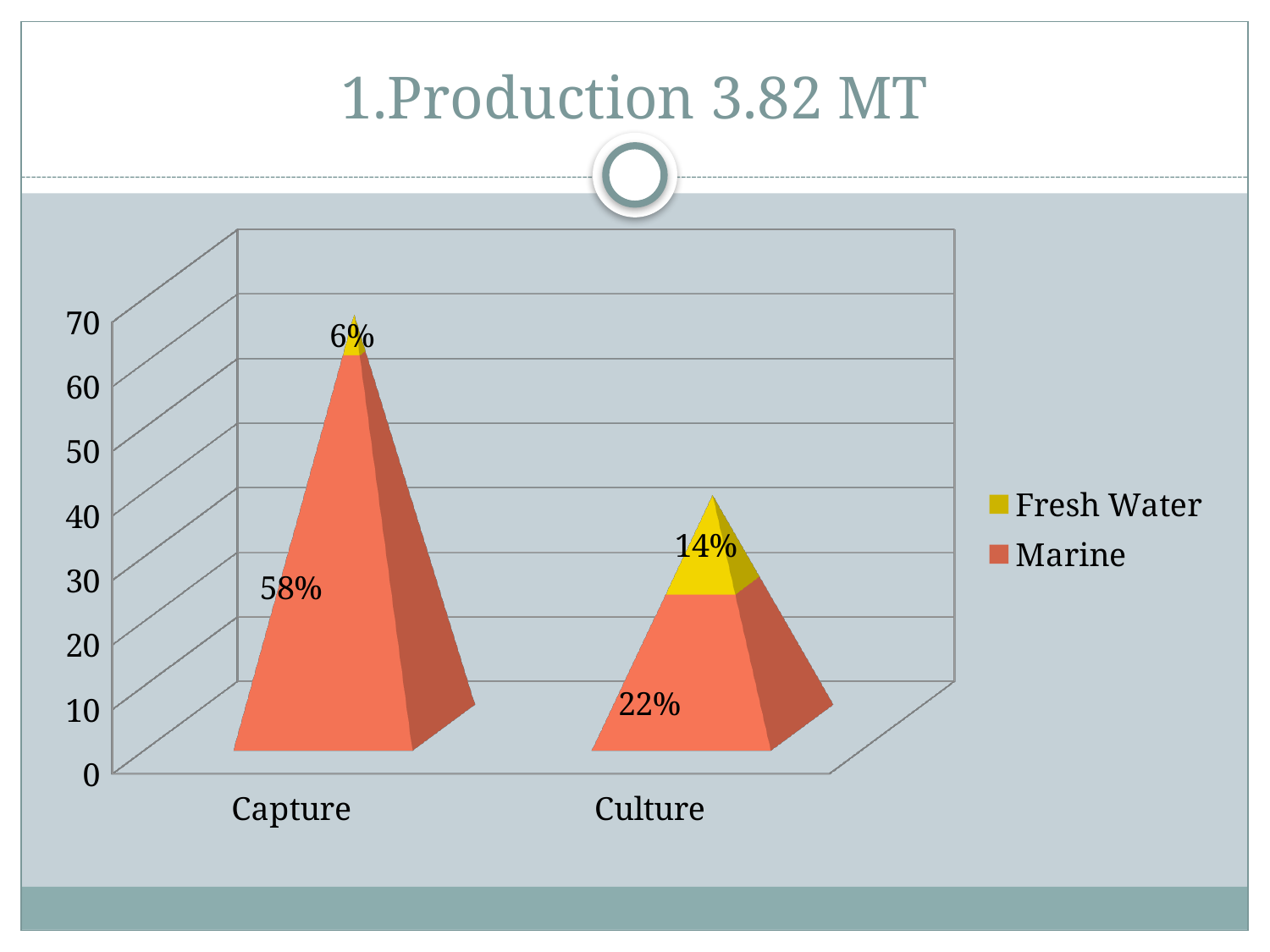
What is the difference between the Marine values for Capture and Culture? 36% What is the Marine value for Capture? 58% What is the Marine value for Culture? 22% Which category has the lowest Fresh Water value? Capture How many categories are shown on the x axis? 2 What is the total of the stacked bar for Culture? 36% How many series does the legend list? 2 What is the Fresh Water value for Capture? 6% Which category has the higher Marine value, Capture or Culture? Capture What kind of chart is shown on the slide? Stacked bar chart What is the total of the stacked bar for Capture? 64% What is the Fresh Water value for Culture? 14%